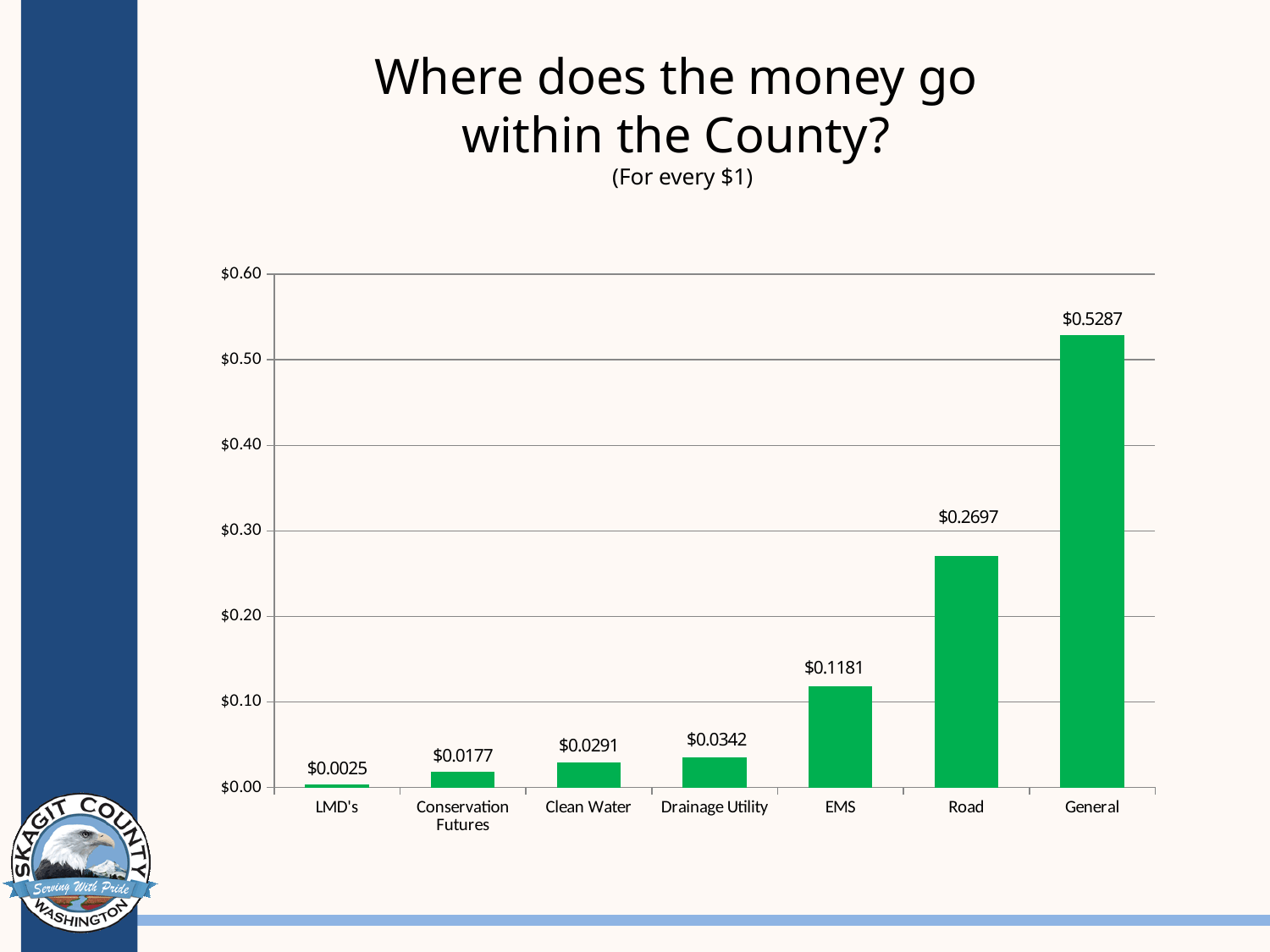
What is the difference between the values for Drainage Utility and Clean Water? $0.0051 Is the value for Road greater or less than $0.30? less What is the value for Conservation Futures? $0.0177 Which is larger, the value for EMS or the value for Drainage Utility? EMS What is the difference between the values for General and Road? $0.2590 Which category has the lowest value? LMD's What kind of chart is shown on the slide? bar chart Which category has the highest value? General How many categories are shown on the x axis? 7 What is the value for EMS? $0.1181 Do the values rise or fall moving from left to right along the x axis? rise What is the value for General? $0.5287